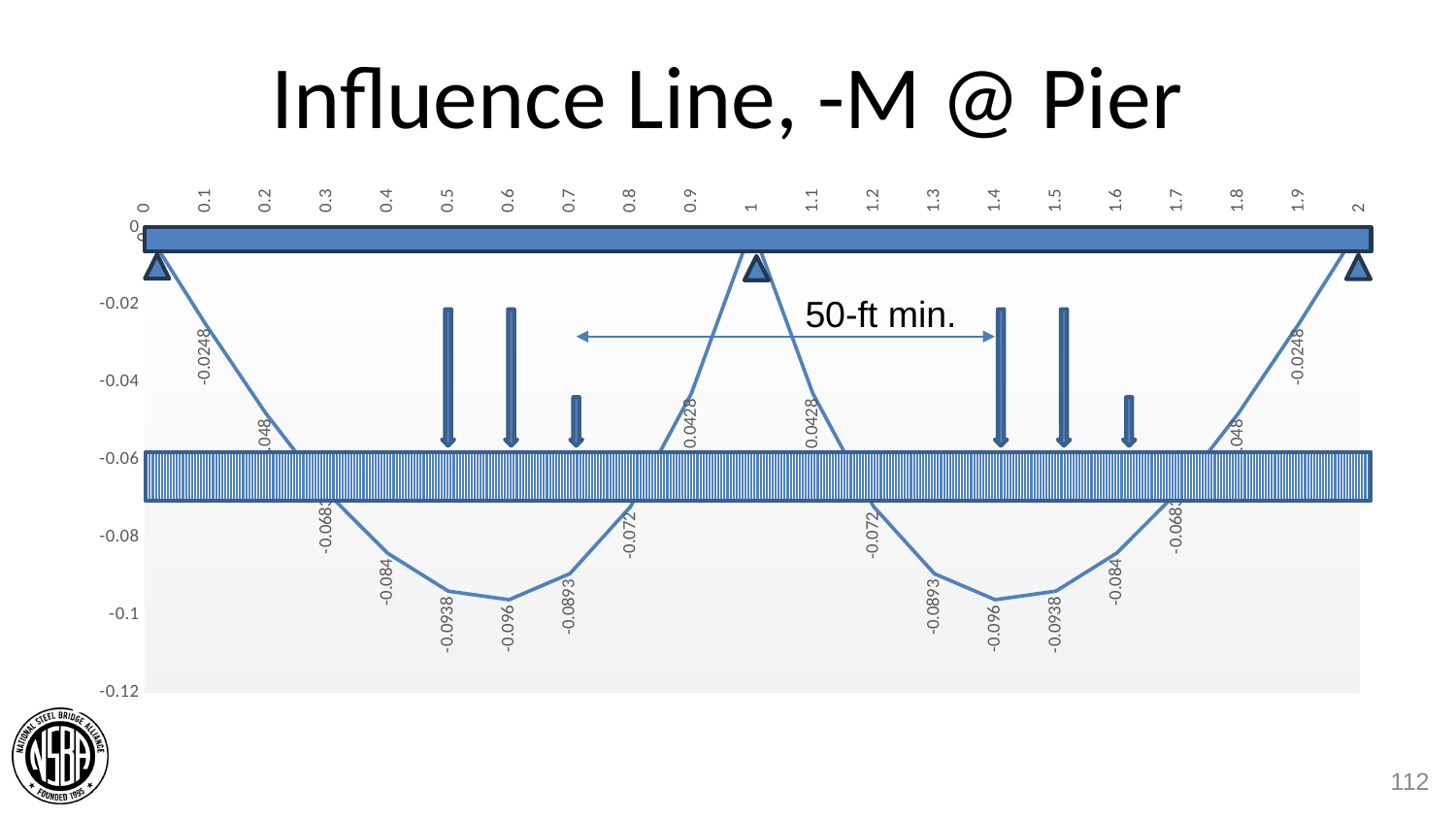
What is the title of the chart? Influence Line, -M @ Pier What is the value of the influence line at x = 0.9? -0.0428 What is the value of the influence line at x = 1.3? -0.0893 What minimum spacing is labelled by the horizontal arrow on the chart? 50-ft min. What is the lowest value plotted on the influence line? -0.096 Do the values rise or fall as x goes from 0 to 0.6? fall What is the value of the influence line at x = 0.5? -0.0938 What is the value of the influence line at x = 0.1? -0.0248 What is the value of the influence line at x = 0.6? -0.096 What is the difference between the values at x = 0.5 and x = 0.6? 0.0022 Which is larger, the value at x = 0.8 or the value at x = 0.5? x = 0.8 What kind of chart is shown on the slide? line chart